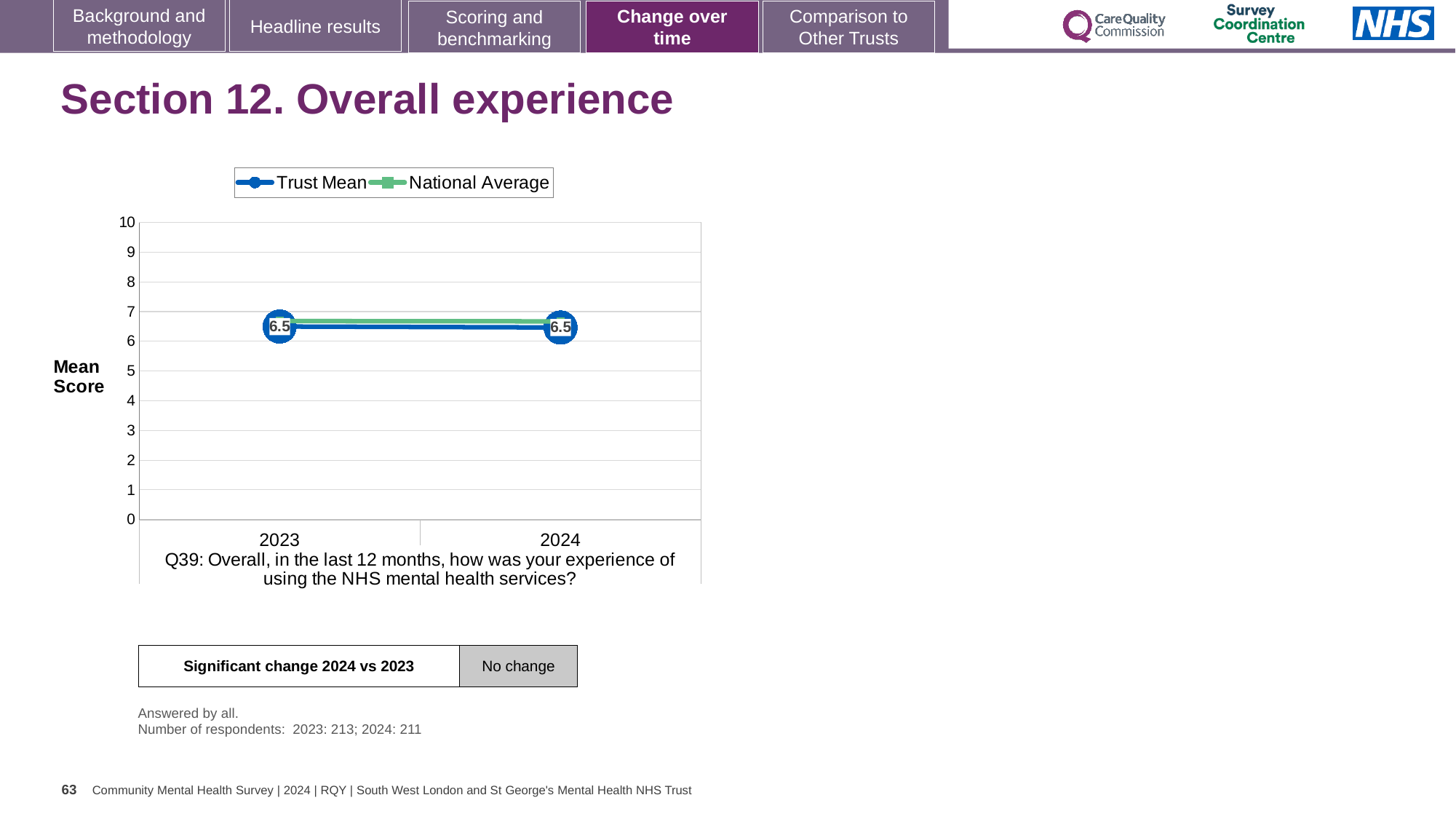
What is the difference between the Trust Mean in 2024 and in 2023? 0 Does the Trust Mean rise, fall or stay the same from 2023 to 2024? Stays the same What kind of chart is shown on the slide? Line chart What is the label on the chart's y axis? Mean Score What are the two series named in the chart legend? Trust Mean and National Average What is the Trust Mean value for 2023? 6.5 Is the Trust Mean value for 2024 greater or less than 7? less What is the Trust Mean value for 2024? 6.5 How many series does the chart legend list? 2 Is the National Average value for 2023 greater or less than 5? greater Is the National Average value for 2024 greater or less than 8? less How many years are plotted on the x axis? 2